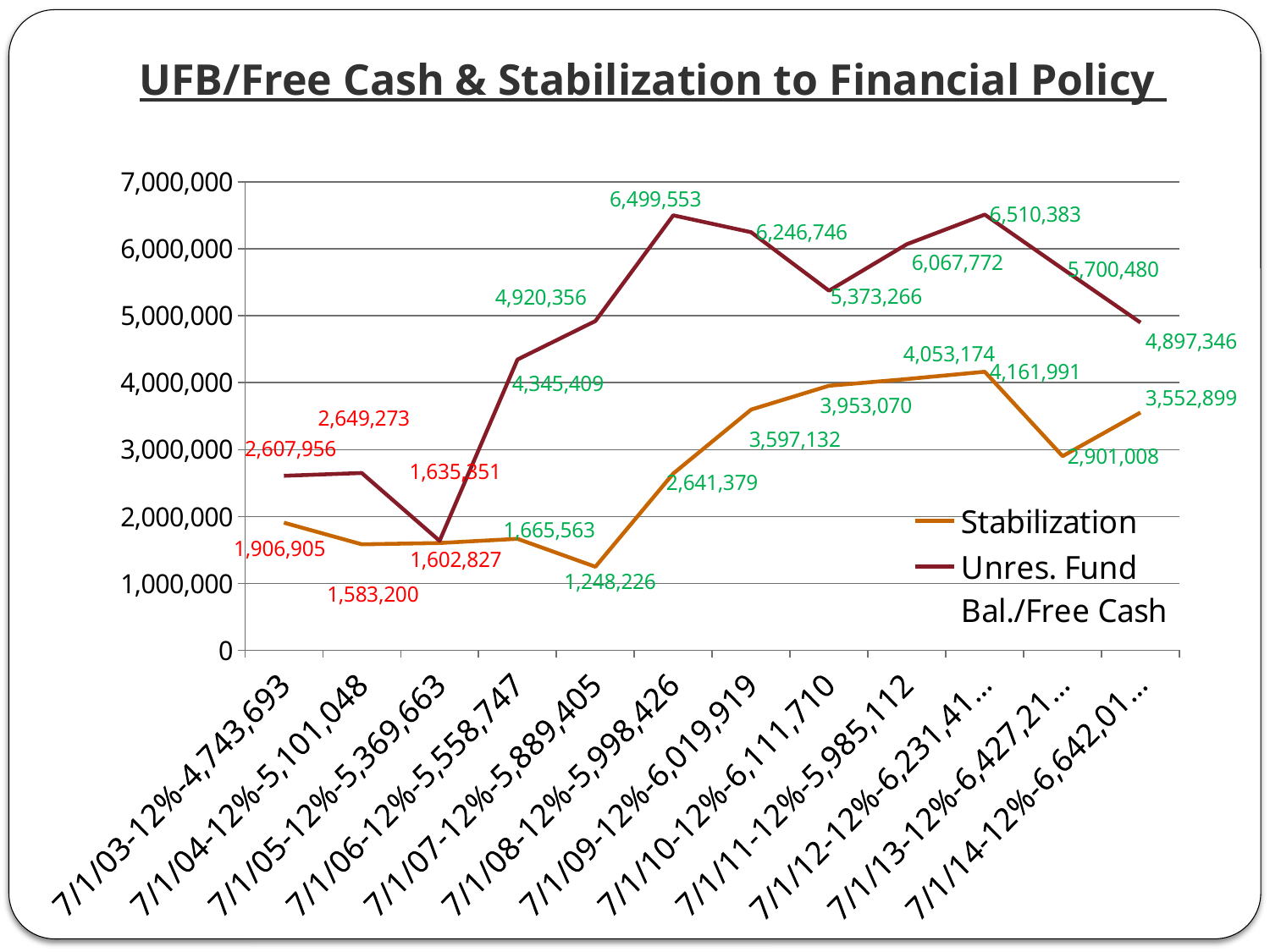
Is the Unres. Fund Bal./Free Cash value for 7/1/09-12%-6,019,919 greater or less than 6,000,000? greater How many categories are shown on the x axis? 12 What kind of chart is shown on the slide? line chart Which category has the lowest Unres. Fund Bal./Free Cash value? 7/1/05-12%-5,369,663 Which category has the lowest Stabilization value? 7/1/07-12%-5,889,405 Does the Unres. Fund Bal./Free Cash line rise or fall from 7/1/12 to 7/1/14? fall What is the Stabilization value for 7/1/03-12%-4,743,693? 1,906,905 What is the Unres. Fund Bal./Free Cash value for 7/1/08-12%-5,998,426? 6,499,553 How many series does the legend list? 2 Which is larger for 7/1/05-12%-5,369,663: the Unres. Fund Bal./Free Cash value or the Stabilization value? Unres. Fund Bal./Free Cash What is the difference between the Unres. Fund Bal./Free Cash value and the Stabilization value for 7/1/08-12%-5,998,426? 3,858,174 What is the Stabilization value for 7/1/10-12%-6,111,710? 3,953,070